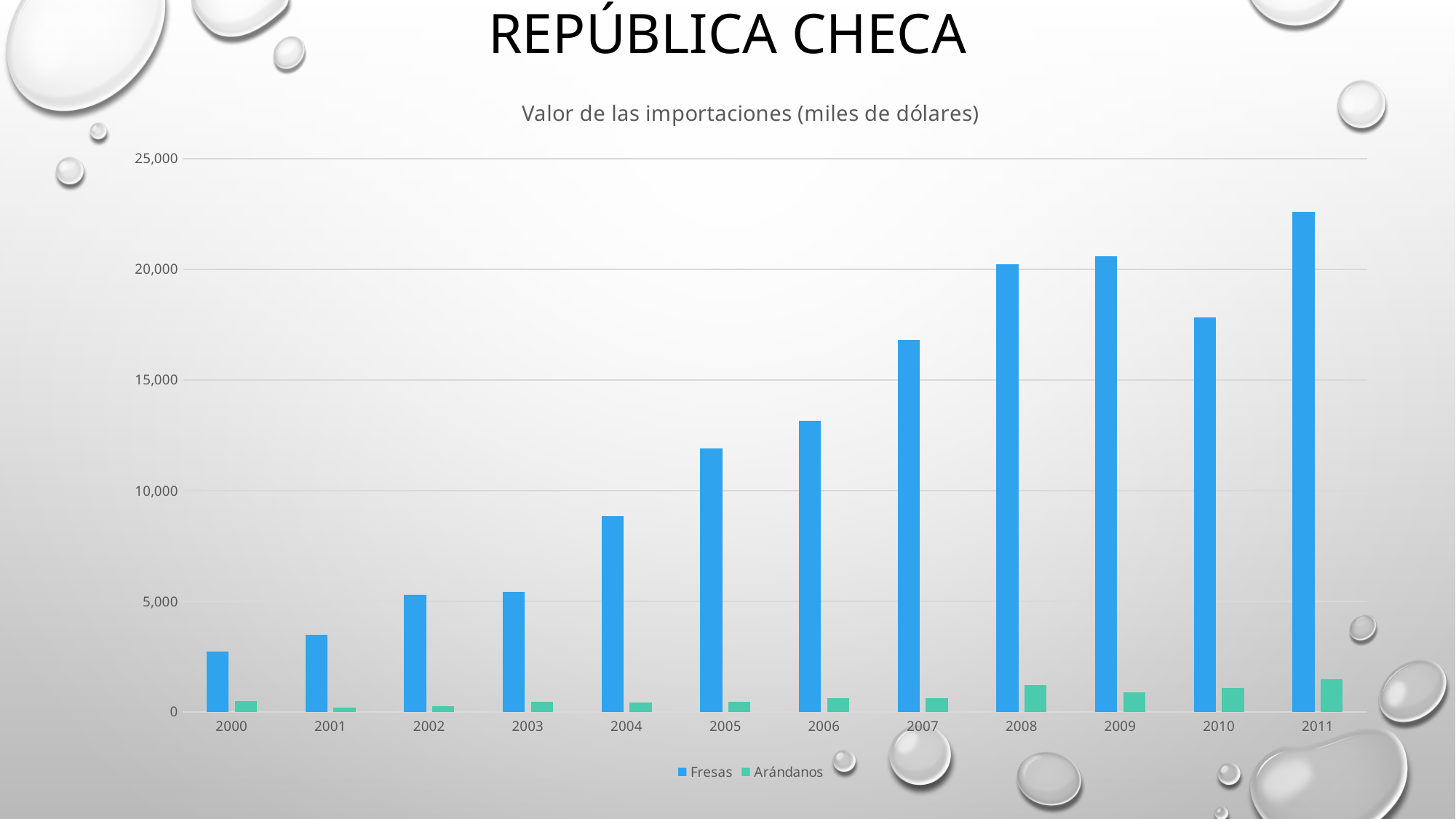
Do the values for Fresas generally rise or fall from 2000 to 2011? Rise Is the value for Fresas in 2004 greater or less than 10,000? less What is the title of the chart? Valor de las importaciones (miles de dólares) In which year is the value for Fresas highest? 2011 What type of chart is shown on the slide? Bar chart Which is larger, the value for Fresas in 2009 or in 2010? 2009 How many series does the legend list? 2 How many years are shown on the x axis? 12 Is the value for Fresas in 2011 greater or less than 20,000? greater In which year is the value for Arándanos highest? 2011 Is the value for Fresas in 2010 greater or less than 20,000? less In which year is the value for Fresas lowest? 2000